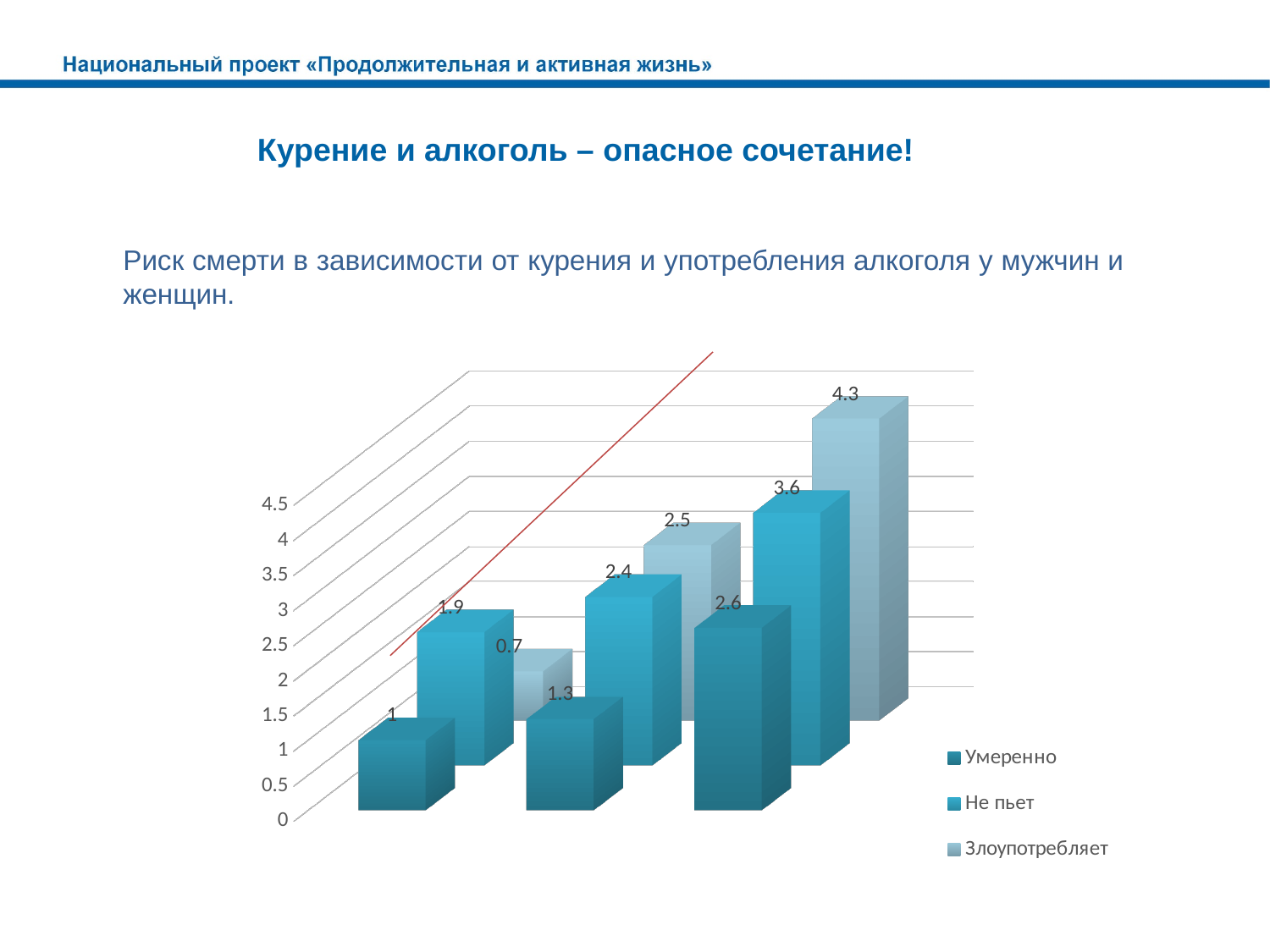
How many series does the chart legend list? 3 Which legend entry is shown with the lightest blue colour? Злоупотребляет What kind of chart is shown on the slide? bar chart How many groups of bars are plotted along the x axis? 3 Which series has the highest value in the rightmost group? Злоупотребляет What is the value of the "Умеренно" bar in the middle group? 1.3 What is the value of the "Не пьет" bar in the leftmost group? 1.9 Which series has the lowest value in the leftmost group? Злоупотребляет Do the "Умеренно" values rise or fall from the leftmost group to the rightmost group? rise What is the difference between the "Злоупотребляет" value in the rightmost group (4.3) and the "Злоупотребляет" value in the leftmost group (0.7)? 3.6 Which is larger: the "Не пьет" value in the middle group or the "Умеренно" value in the rightmost group? Умеренно value in the rightmost group (2.6) What is the value of the "Злоупотребляет" bar in the rightmost group? 4.3